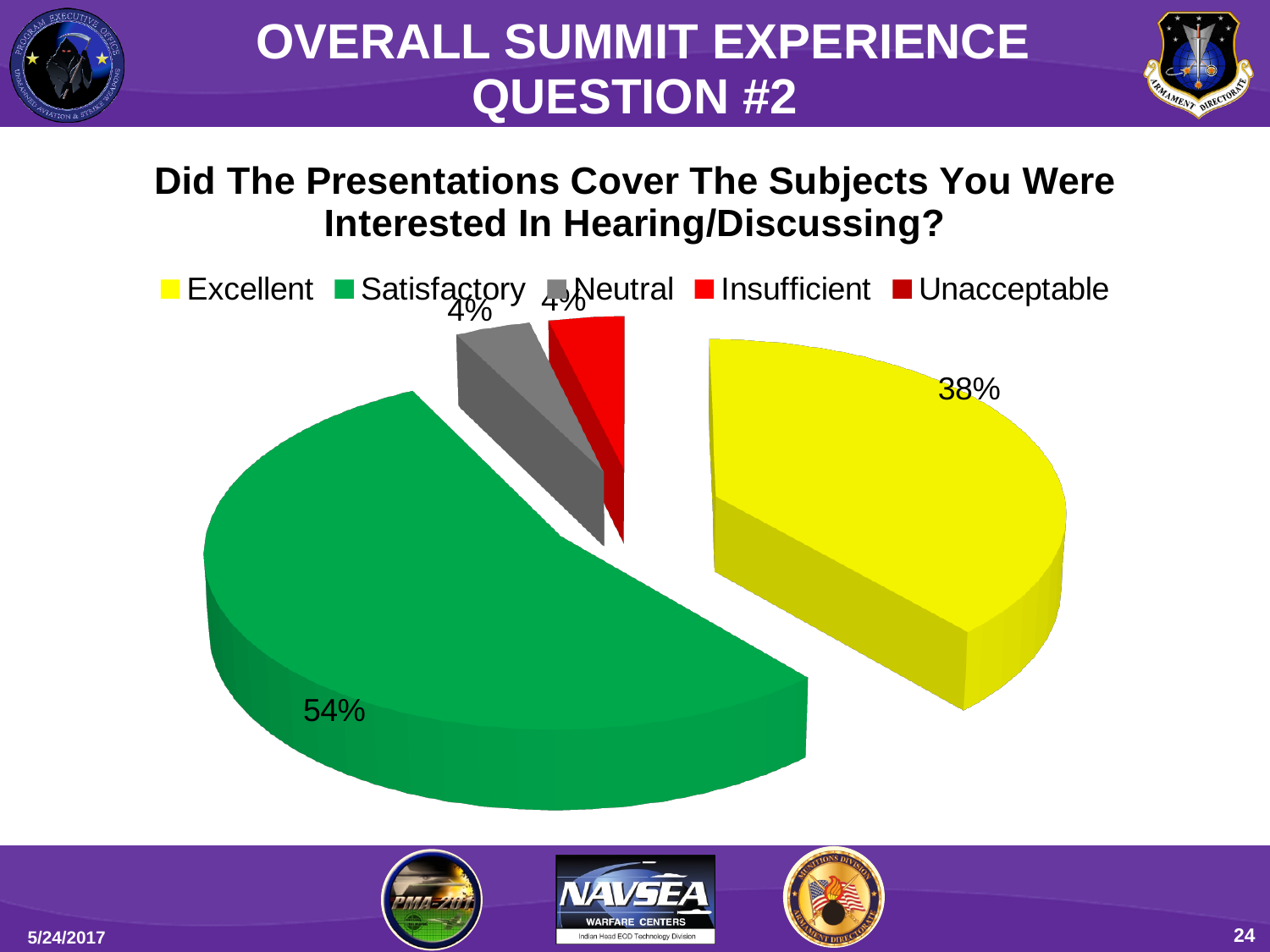
What percentage of responses were Neutral? 4% What percentage of responses were Excellent? 38% What colour represents the Excellent category in the chart? Yellow What kind of chart is shown on the slide? Pie chart What percentage of responses were Insufficient? 4% What question does the chart on the slide present results for? Did The Presentations Cover The Subjects You Were Interested In Hearing/Discussing? By how many percentage points does the Satisfactory share exceed the Excellent share? 16 percentage points How many categories does the legend list? 5 Which response category has the largest share of the pie? Satisfactory What percentage of responses were Satisfactory? 54% Which is larger, the Excellent share or the Satisfactory share? Satisfactory What is the combined share of the Excellent and Satisfactory responses? 92%